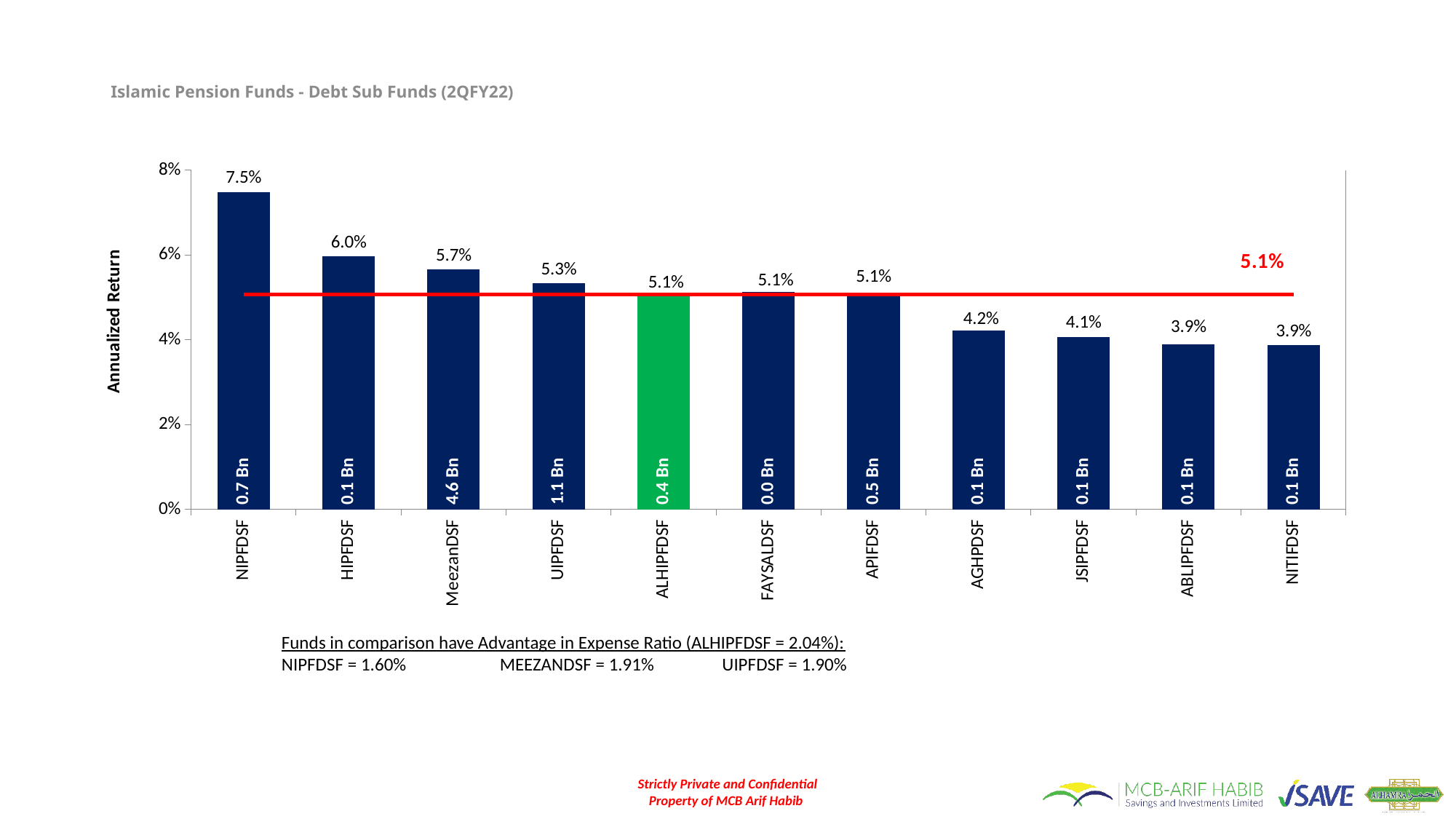
How many funds are shown in the chart? 11 What is the annualized return for NIPFDSF? 7.5% What is the annualized return for AGHPDSF? 4.2% What kind of chart is shown on the slide? bar chart What fund size is printed inside the MeezanDSF bar? 4.6 Bn Which fund's bar is coloured green? ALHIPFDSF Is the annualized return for ABLIPFDSF greater or less than 4%? less What is the annualized return for MeezanDSF? 5.7% Which has a higher annualized return, UIPFDSF or JSIPFDSF? UIPFDSF Which fund has the highest annualized return? NIPFDSF What value is labelled on the red horizontal line? 5.1% What is the difference in annualized return between NIPFDSF and HIPFDSF? 1.5%